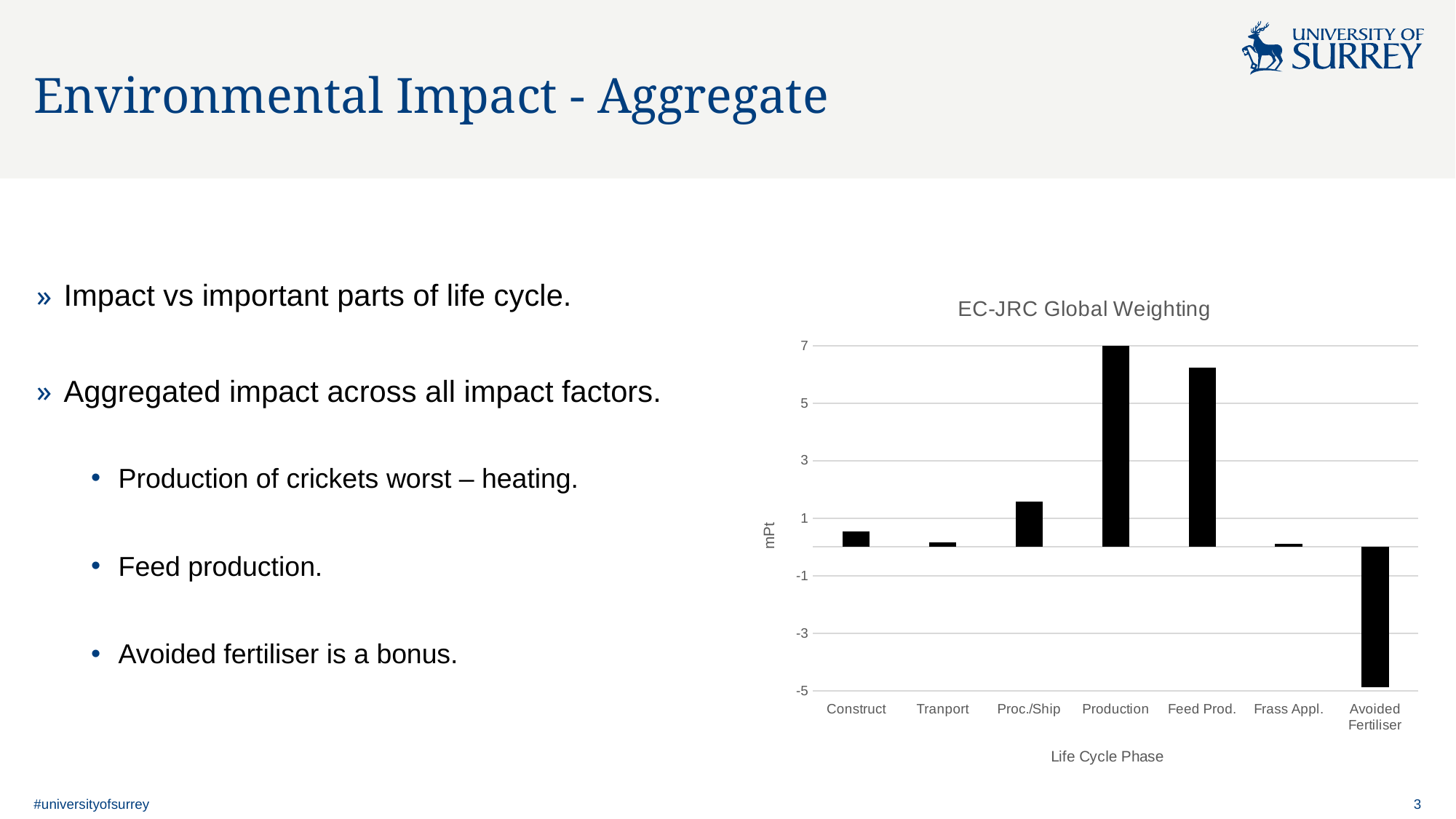
Which life cycle phase has the highest value in the chart? Production Is the value for Avoided Fertiliser greater or less than -3? less Which has the larger value, Proc./Ship or Construct? Proc./Ship How many life cycle phases are plotted on the x axis of the chart? 7 Is the value for Construct greater or less than 1? less Which has the larger value, Production or Feed Prod.? Production Is the value for Production greater or less than 5? greater What kind of chart is shown on the slide? bar chart Which life cycle phase has the lowest value in the chart? Avoided Fertiliser What is the title of the chart? EC-JRC Global Weighting What unit is shown on the y axis of the chart? mPt